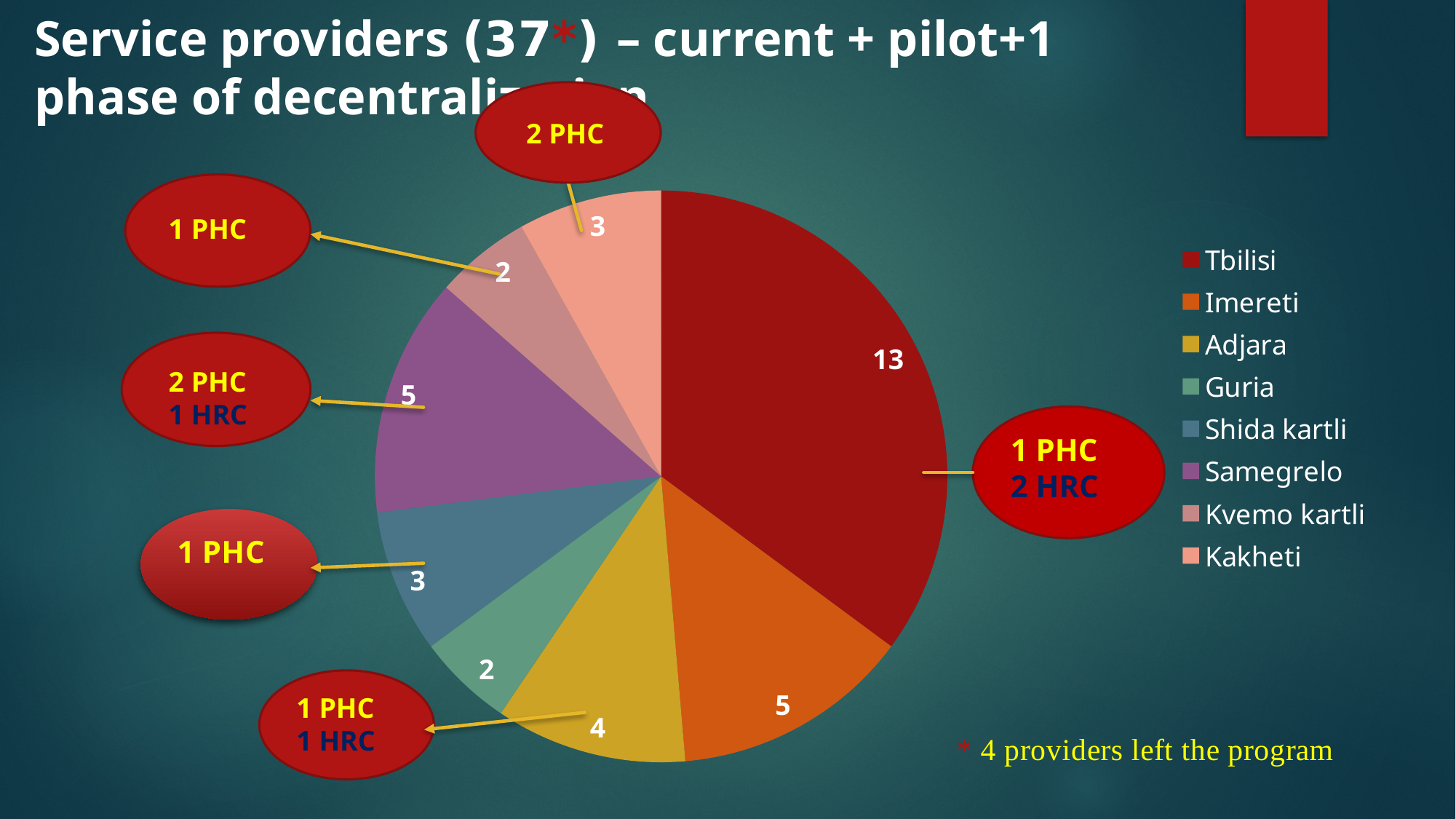
What is the difference between the values for Samegrelo and Kakheti? 2 What is the value for Shida kartli in the pie chart? 3 What type of chart is shown on the slide? pie chart How many regions are listed in the pie chart legend? 8 What is the value for Tbilisi in the pie chart? 13 What is the difference between the values for Tbilisi and Imereti? 8 What is the value for Imereti in the pie chart? 5 Which is larger, the value for Adjara or the value for Guria? Adjara Which region has the largest slice of the pie chart? Tbilisi What is the value for Adjara in the pie chart? 4 Which region is shown in purple in the pie chart? Samegrelo What is the value for Samegrelo in the pie chart? 5